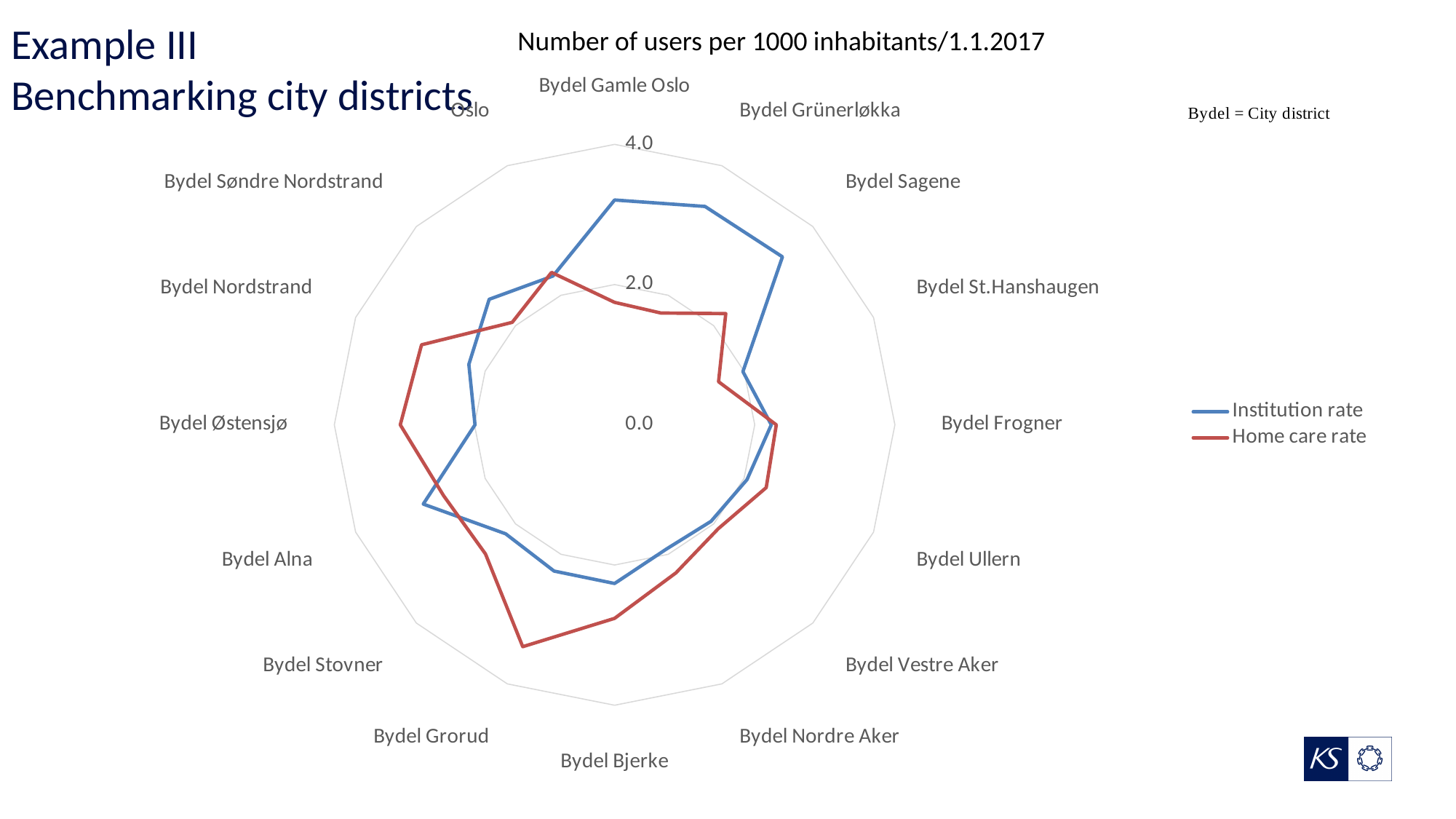
What kind of chart is shown on the slide? Radar chart For Bydel Grünerløkka, which is larger: the Institution rate or the Home care rate? Institution rate Is the Home care rate for Bydel Østensjø greater or less than 2.0? greater Which colour represents the Home care rate series? Red How many series does the legend list? 2 What is the title of the chart? Number of users per 1000 inhabitants/1.1.2017 Which city district has the highest Home care rate? Bydel Grorud How many categories (axes) does the radar chart have? 16 Is the Institution rate for Bydel Sagene greater or less than 2.0? greater For Bydel Nordstrand, which is larger: the Institution rate or the Home care rate? Home care rate Is the Institution rate for Bydel Gamle Oslo greater or less than 2.0? greater